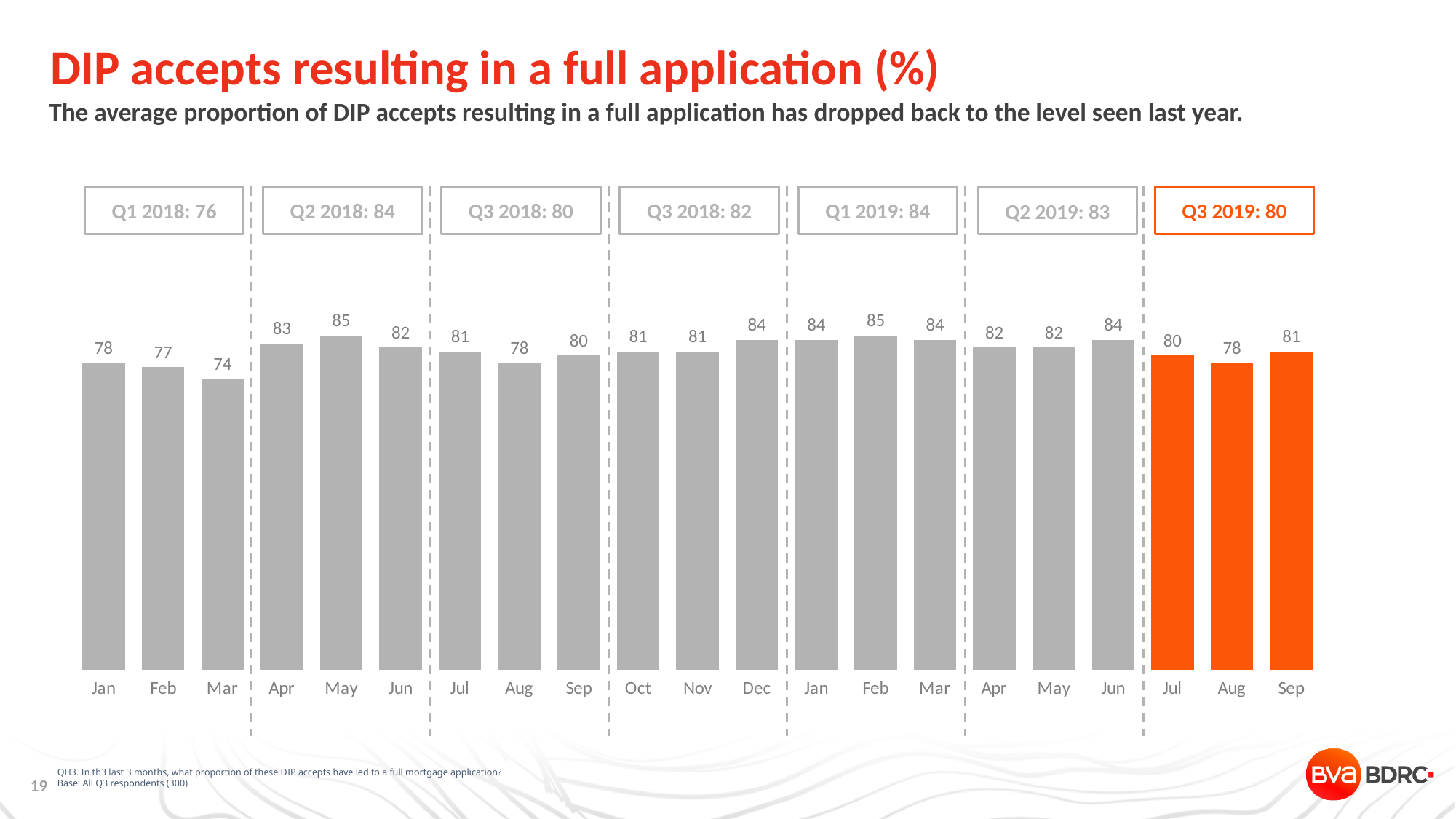
Which bars are coloured orange rather than grey? Jul, Aug and Sep 2019 (Q3 2019) What is the value for Sep in Q3 2019 (the orange bars)? 81 What is the difference between the value for Aug 2019 and the value for Sep 2019? 3 How many monthly bars are plotted in the chart? 21 What quarterly average is shown in the box for Q3 2019? 80 Which month has the lowest value in the chart? Mar 2018 What is the value for Mar in Q1 2018? 74 What is the difference between the value for May 2018 and the value for Mar 2018? 11 What is the value for Dec in 2018? 84 What kind of chart is shown on the slide? Bar chart Do the values rise or fall across the three months of Q1 2018 (Jan to Mar)? Fall Which is larger, the value for Jun 2019 or the value for Jul 2019? Jun 2019